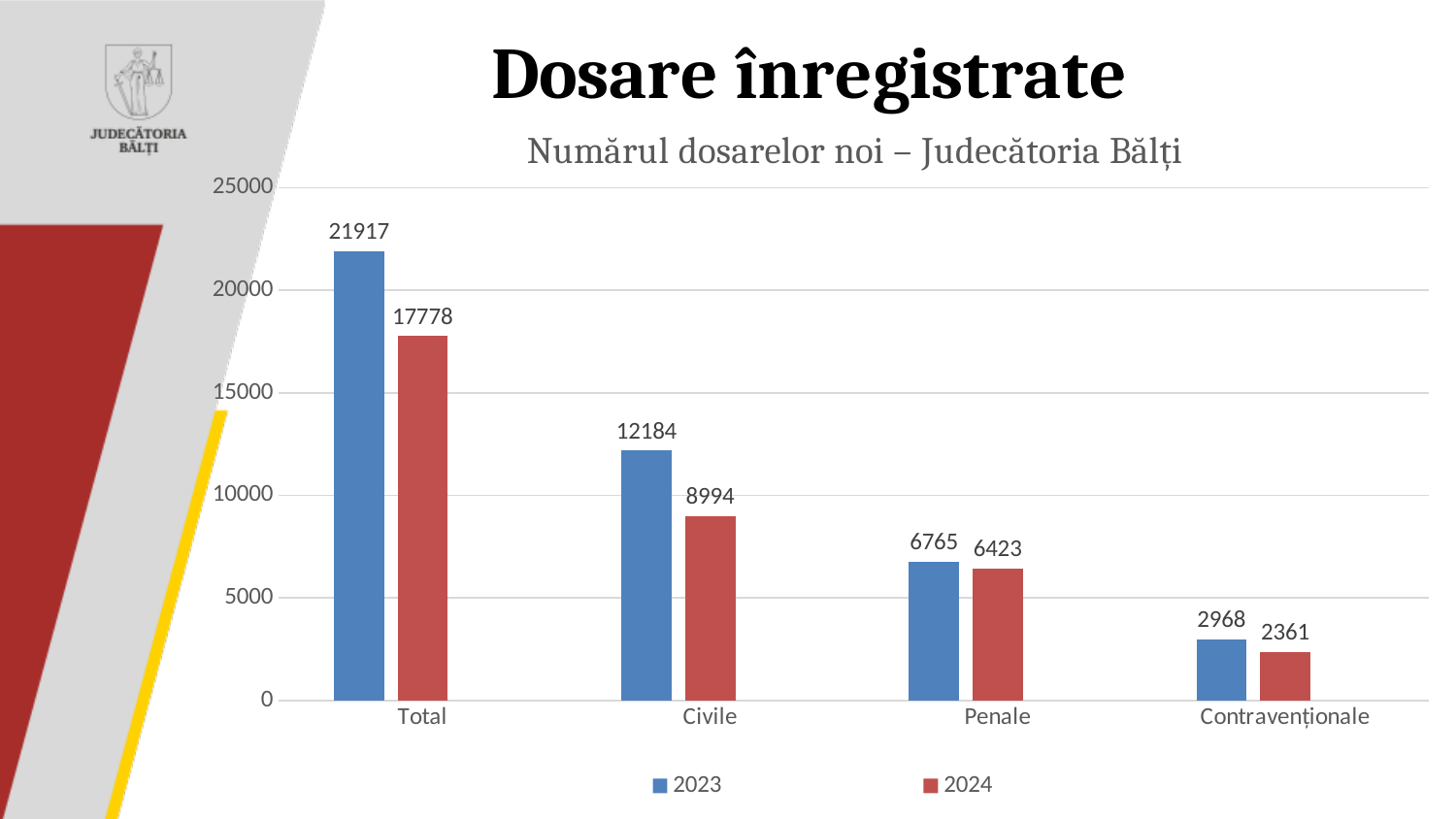
What is the difference between the 2023 and 2024 values for Total? 4139 How many categories are shown on the x axis? 4 Which category has the highest value in the 2023 series? Total What is the value for Contravenționale in the 2023 series? 2968 What kind of chart is shown on the slide? Bar chart What is the value for Penale in the 2024 series? 6423 How many series does the legend list? 2 Which category has the lowest value in the 2024 series? Contravenționale What is the difference between the 2023 and 2024 values for Civile? 3190 What is the subtitle shown above the chart? Numărul dosarelor noi – Judecătoria Bălți Which is larger, the 2023 value for Penale or the 2024 value for Penale? 2023 What is the value for Civile in the 2023 series? 12184